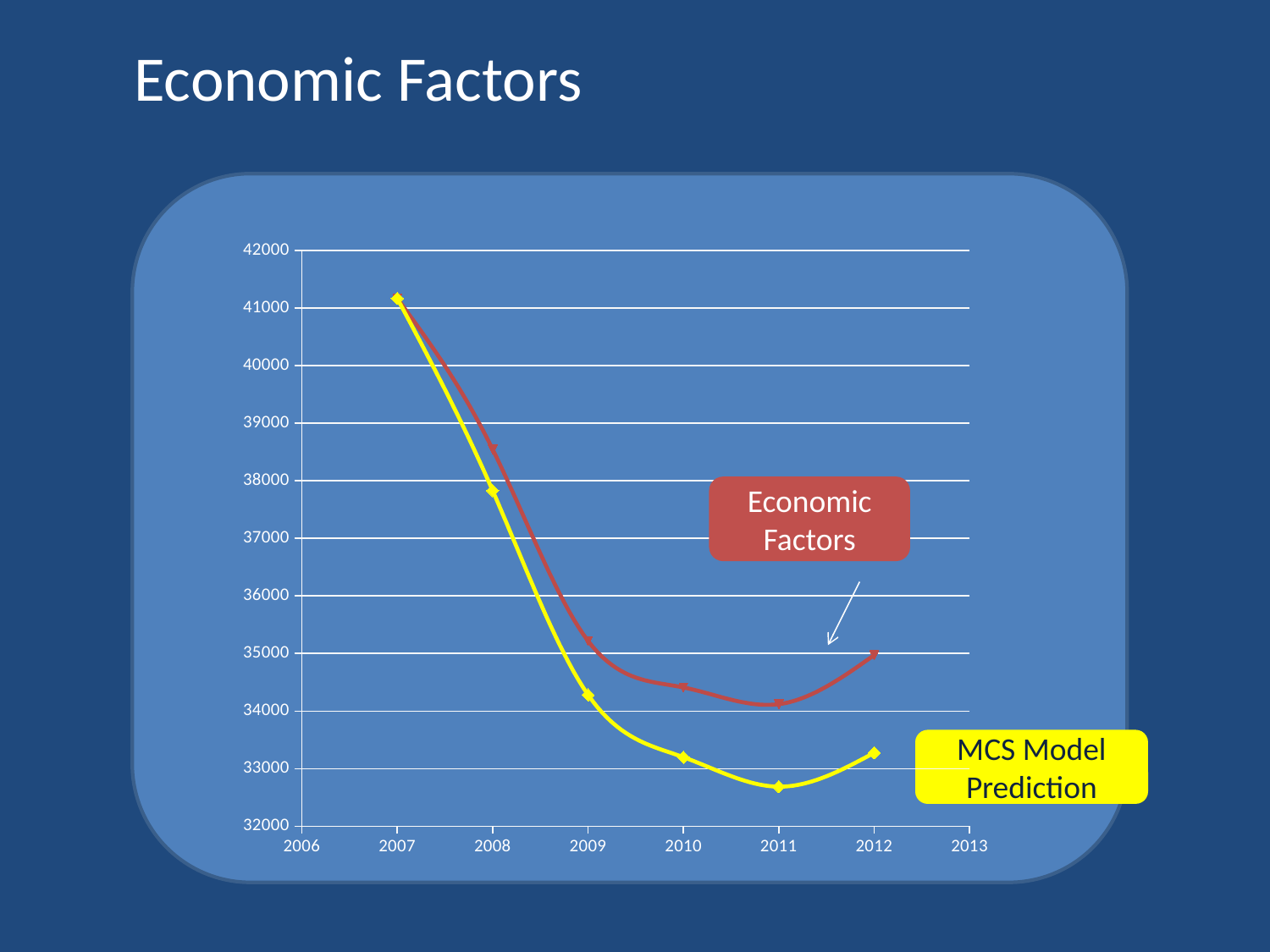
In which year is the MCS Model Prediction value lowest? 2011 Is the MCS Model Prediction value for 2011 greater or less than 33000? less Is the MCS Model Prediction value for 2009 greater or less than 34000? greater Is the Economic Factors value for 2011 greater or less than 35000? less In 2009, which series has the higher value, Economic Factors or MCS Model Prediction? Economic Factors How many series are plotted on the chart? 2 What colour is the MCS Model Prediction line? yellow What kind of chart is shown on the slide? line chart How many data points does the MCS Model Prediction series have? 6 In which year is the Economic Factors value highest? 2007 Do the Economic Factors values rise or fall from 2007 to 2011? fall